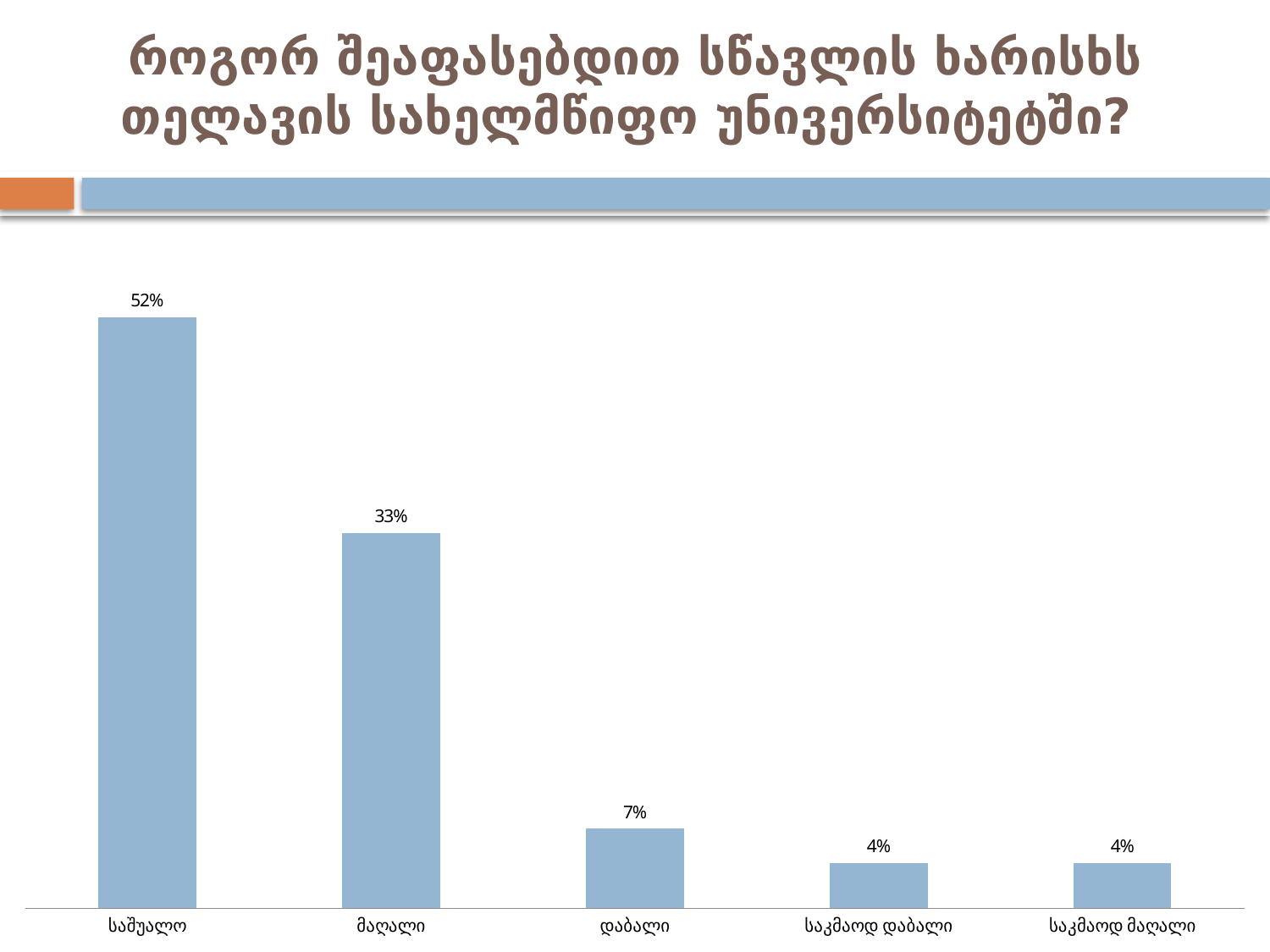
What is the difference between the values for საშუალო and მაღალი? 19 percentage points What is the value for მაღალი? 33% What is the value for დაბალი? 7% What is the difference between the values for მაღალი and დაბალი? 26 percentage points What kind of chart is shown on the slide? Bar chart What is the value for საშუალო? 52% How many categories are shown on the chart? 5 What is the value for საკმაოდ დაბალი? 4% Which is larger, the value for მაღალი or the value for დაბალი? მაღალი Do the values generally rise or fall from left to right along the x axis? Fall Which category has the highest value? საშუალო What is the value for საკმაოდ მაღალი? 4%